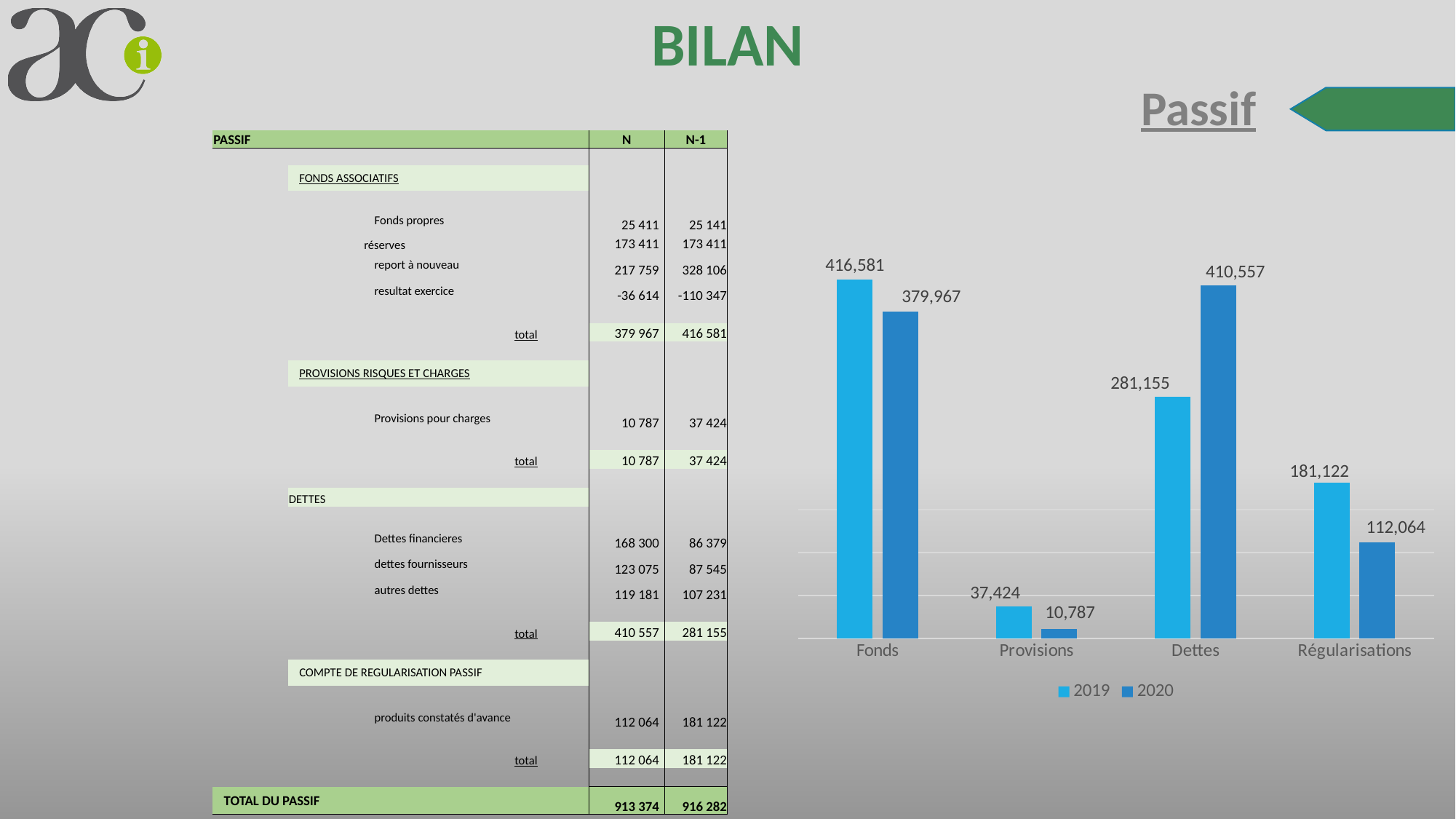
How many series does the chart legend list? 2 What is the value for Régularisations in the 2019 series? 181,122 What is the value for Provisions in the 2020 series? 10,787 Which category has the lowest value in the 2019 series? Provisions What is the value for Dettes in the 2020 series? 410,557 How many categories are shown on the x axis of the chart? 4 Which series is shown in the darker blue colour in the chart? 2020 Which category has the highest value in the 2020 series? Dettes What is the difference between the 2019 and 2020 values for Fonds? 36,614 Which is larger for Dettes: the 2019 value or the 2020 value? 2020 What is the value for Fonds in the 2019 series? 416,581 What kind of chart is shown on the slide? Bar chart